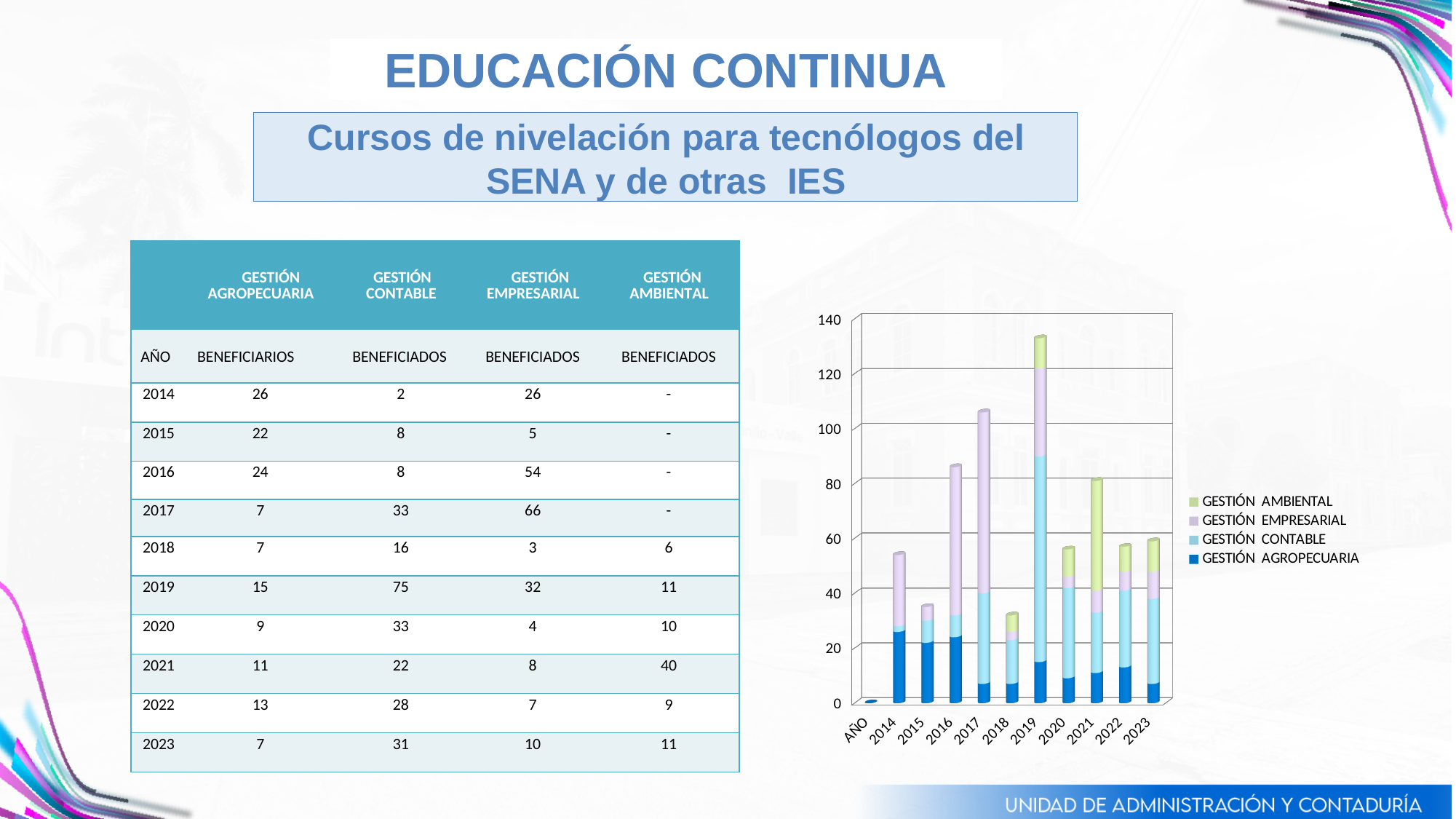
Which year has the larger stacked bar total, 2021 or 2022? 2021 How many series does the chart's legend list? 4 Is the total height of the 2019 bar greater or less than 120? greater What is the difference between the GESTIÓN EMPRESARIAL values for 2017 and 2016? 12 Which year has the tallest stacked bar in the chart? 2019 What is the value of GESTIÓN CONTABLE for 2019? 75 What kind of chart is shown on the right of the slide? Stacked bar chart How many years from 2014 to 2023 are plotted as bars in the chart? 10 Which year has the shortest stacked bar in the chart? 2018 Which colour represents GESTIÓN AMBIENTAL in the chart's legend? Green Is the total height of the 2017 bar greater or less than 100? greater What is the total of the stacked bar for 2014? 54